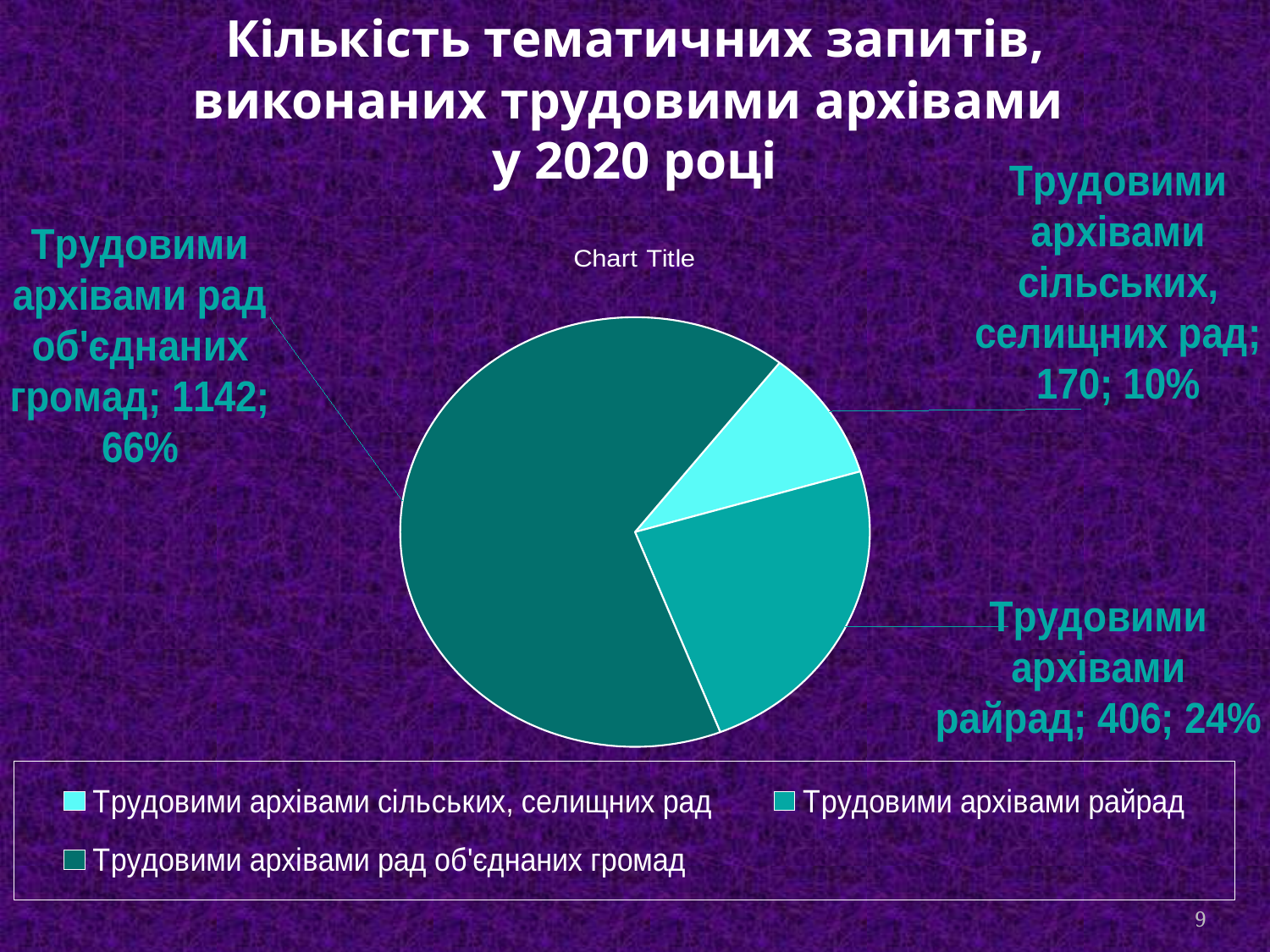
What share of the pie does Трудовими архівами райрад represent? 24% Which category has the largest slice? Трудовими архівами рад об'єднаних громад What share of the pie does Трудовими архівами рад об'єднаних громад represent? 66% What kind of chart is shown on the slide? pie chart How many slices does the pie chart have? 3 What is the value for Трудовими архівами сільських, селищних рад? 170 Which is larger: the value for Трудовими архівами райрад or for Трудовими архівами сільських, селищних рад? Трудовими архівами райрад Which category has the smallest slice? Трудовими архівами сільських, селищних рад What is the value for Трудовими архівами рад об'єднаних громад? 1142 How many entries does the legend list? 3 What is the difference between the values for Трудовими архівами райрад and Трудовими архівами сільських, селищних рад? 236 What is the value for Трудовими архівами райрад? 406